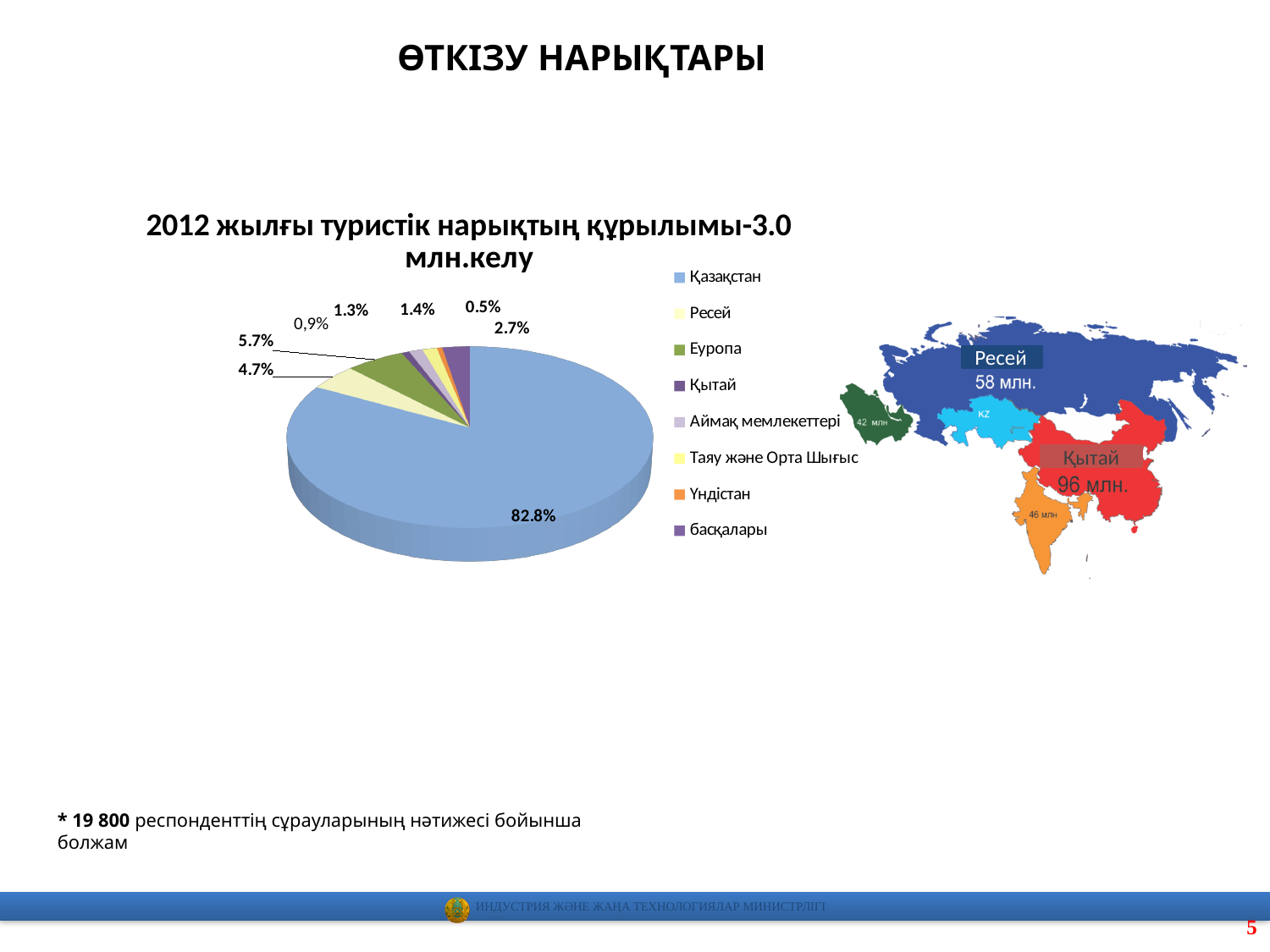
What share of the pie does Ресей hold? 4.7% What is the smallest percentage labelled on the pie chart? 0.5% What share of the pie does Қазақстан hold? 82.8% Is the share for Қазақстан greater or less than 80%? greater What is the difference between the shares of Еуропа and Ресей? 1.0% Which category has the largest slice of the pie? Қазақстан What share of the pie does Еуропа hold? 5.7% Which is larger in the pie chart, the slice for Еуропа or the slice for Ресей? Еуропа How many entries does the legend of the pie chart list? 8 What is the title of the pie chart? 2012 жылғы туристік нарықтың құрылымы-3.0 млн.келу Which legend entry is shown in the first (top) position of the pie chart legend? Қазақстан What kind of chart is shown on the slide? pie chart